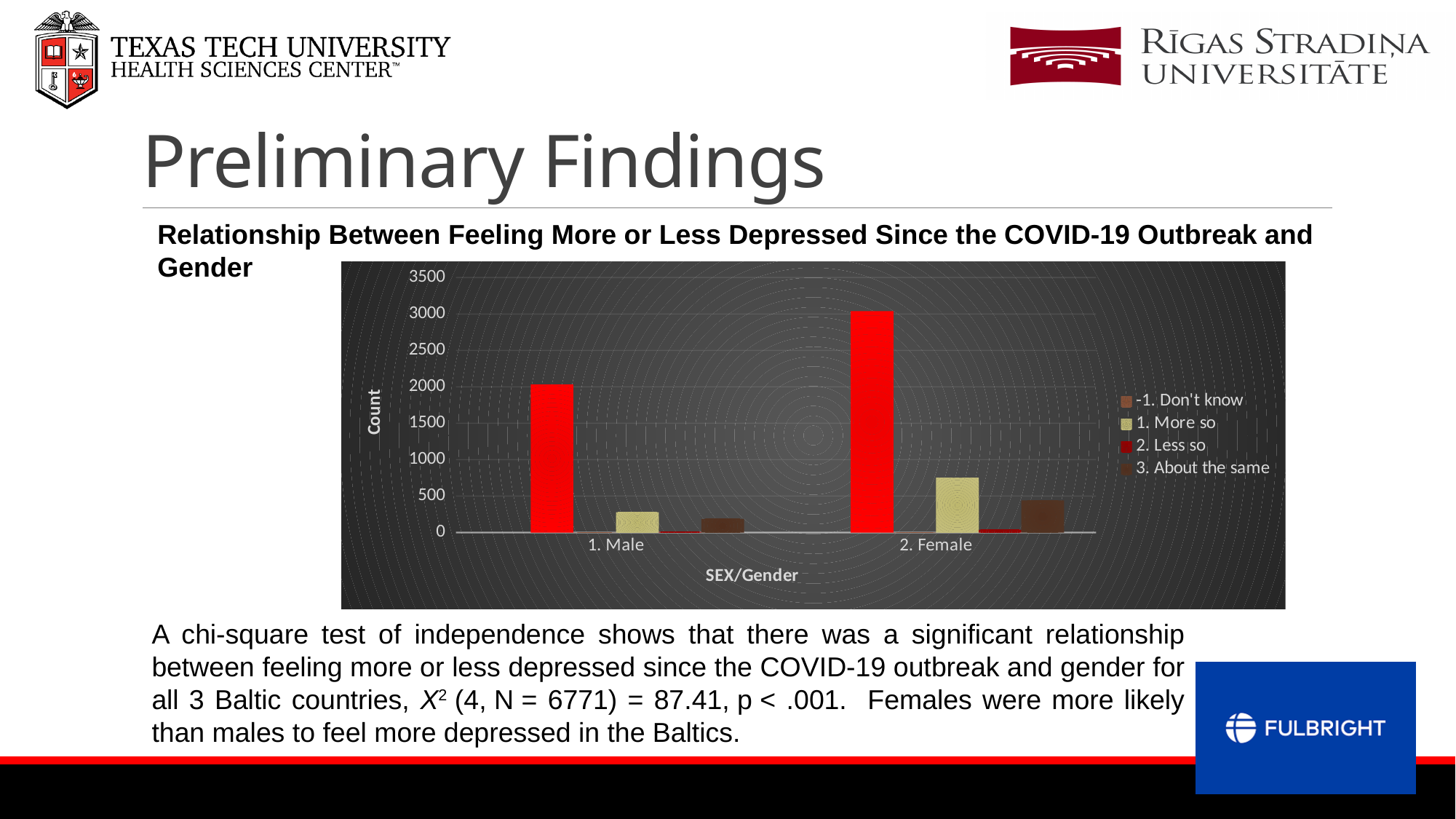
What is the label of the chart's x axis? SEX/Gender Is the tallest bar in the 2. Female category greater or less than 2500? greater What is the label of the chart's y axis? Count How many gender categories are shown on the x axis of the chart? 2 Which category has the larger value for '1. More so', 1. Male or 2. Female? 2. Female Is the tallest bar in the 1. Male category greater or less than 1500? greater How many series does the chart's legend list? 4 Is the value for '1. More so' in the 2. Female category greater or less than 500? greater What kind of chart is shown on the slide? bar chart Which category has the larger value for '3. About the same', 1. Male or 2. Female? 2. Female